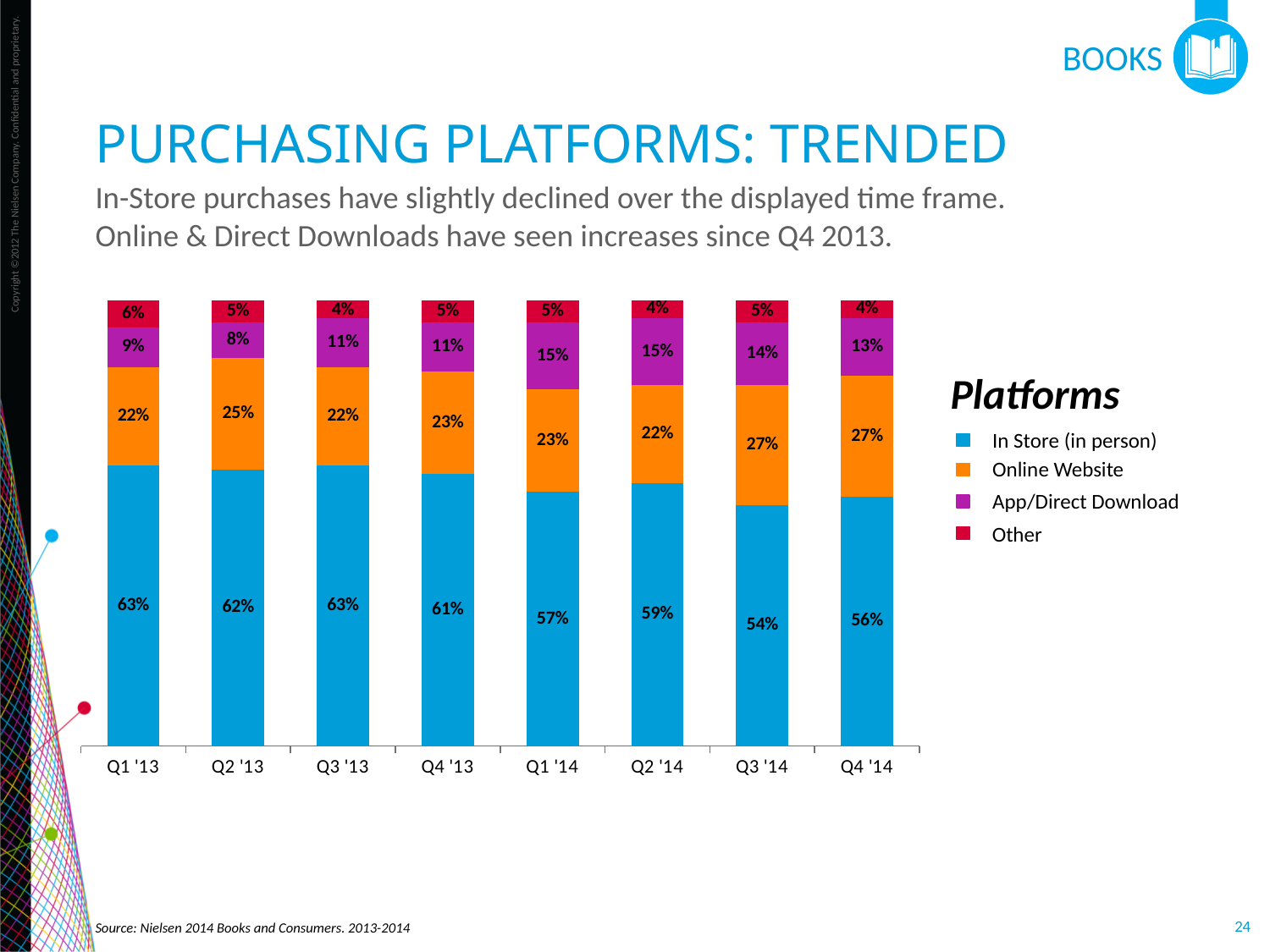
What is the App/Direct Download value for Q4 '14? 13% In which quarter is the In Store (in person) share lowest? Q3 '14 By how many percentage points did the In Store (in person) share fall from Q1 '13 to Q4 '14? 7 percentage points What percentage of purchases were In Store (in person) in Q1 '13? 63% Which quarter has the larger Online Website share, Q2 '13 or Q3 '13? Q2 '13 How many quarters are shown on the x axis? 8 In which quarter is the App/Direct Download share lowest? Q2 '13 How many series does the legend list? 4 What is the Other share in Q1 '13? 6% What is the Online Website share in Q3 '14? 27% What kind of chart is shown on the slide? Stacked bar chart What is the title of the legend? Platforms